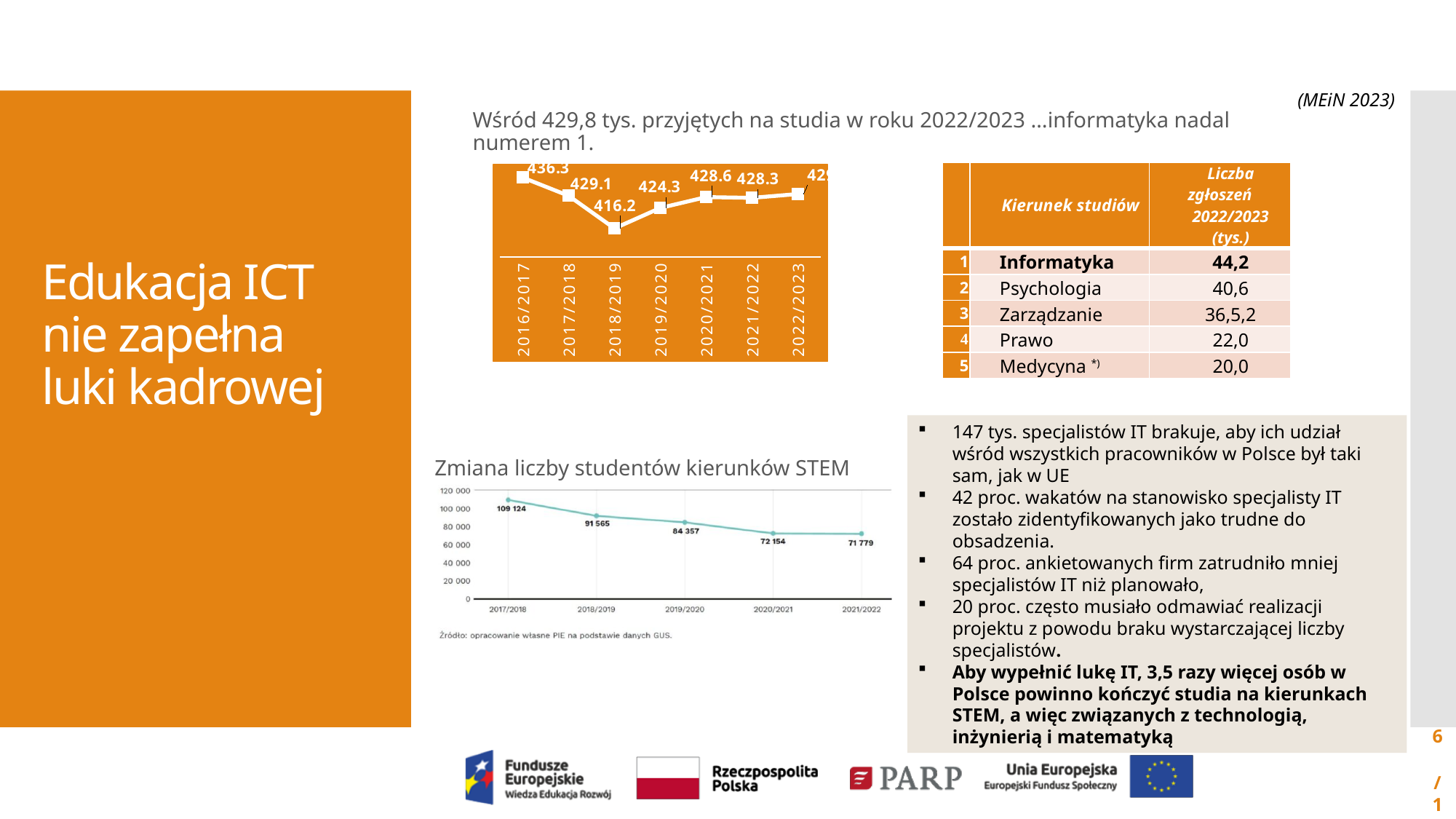
What kind of chart is 'Zmiana liczby studentów kierunków STEM'? line chart In the orange line chart at the top of the slide, which is larger: the value for 2017/2018 or the value for 2019/2020? 2017/2018 In the chart titled 'Zmiana liczby studentów kierunków STEM', what is the value for 2021/2022? 71 779 In the orange line chart at the top of the slide, how many academic years are shown on the x axis? 7 In the orange line chart at the top of the slide, which academic year has the lowest value? 2018/2019 In the orange line chart at the top of the slide, what is the value for 2016/2017? 436.3 In the chart titled 'Zmiana liczby studentów kierunków STEM', what is the value for 2017/2018? 109 124 In the chart titled 'Zmiana liczby studentów kierunków STEM', which academic year has the highest value? 2017/2018 In the chart titled 'Zmiana liczby studentów kierunków STEM', what is the difference between the values for 2017/2018 and 2018/2019? 17 559 In the chart titled 'Zmiana liczby studentów kierunków STEM', do the values rise or fall from 2017/2018 to 2021/2022? fall In the chart titled 'Zmiana liczby studentów kierunków STEM', how many data points are plotted? 5 In the orange line chart at the top of the slide, what is the value for 2018/2019? 416.2